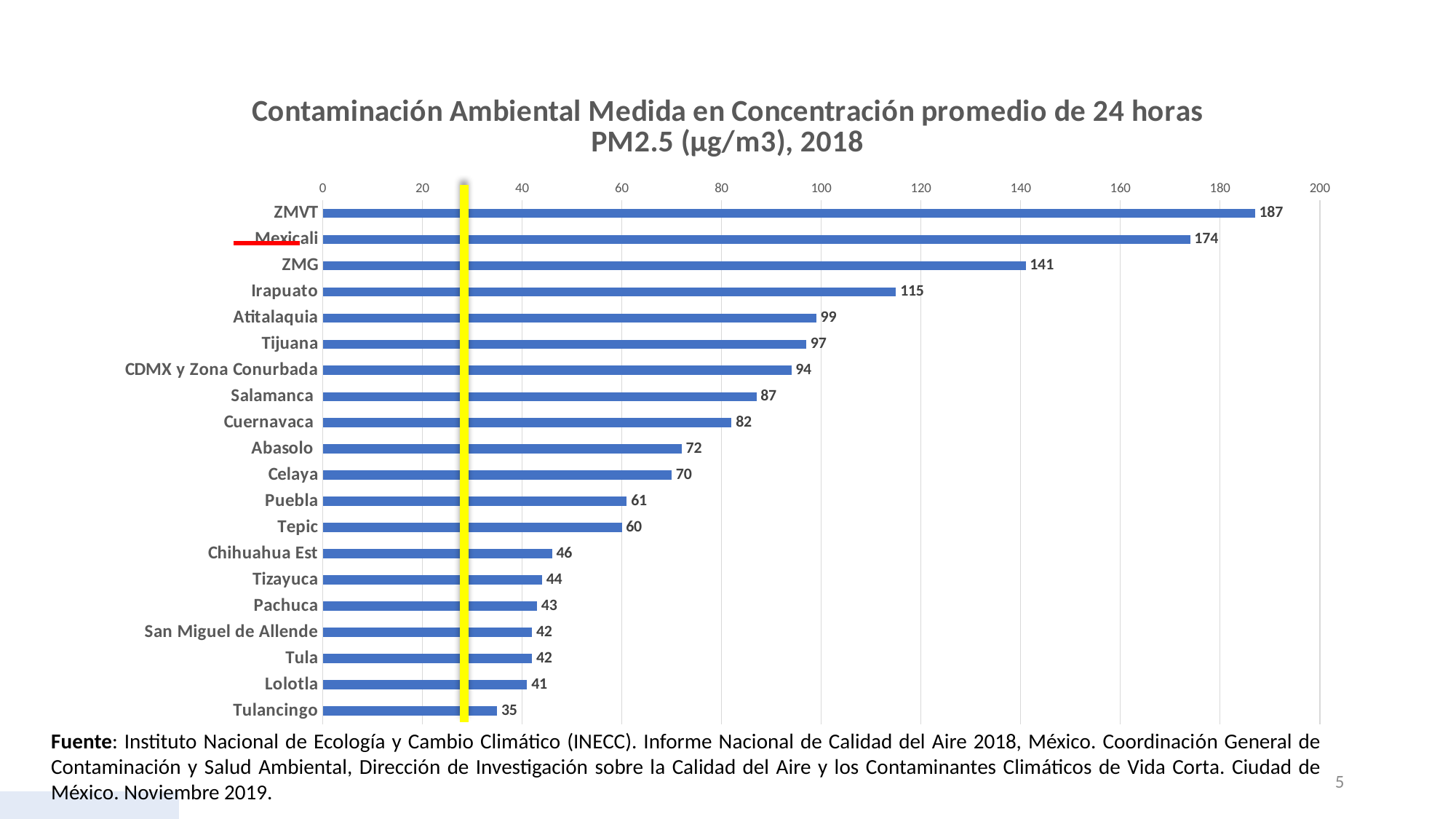
Which category has the lowest PM2.5 value? Tulancingo What is the difference between the values for ZMG and Irapuato? 26 What kind of chart is shown on the slide? bar chart What is the PM2.5 value for CDMX y Zona Conurbada? 94 Which category has the highest PM2.5 value? ZMVT What is the PM2.5 value for Mexicali? 174 How many categories are shown in the chart? 20 What is the difference between the values for ZMVT and Mexicali? 13 What year is stated in the chart title? 2018 Is the value for Cuernavaca greater or less than 100? less What is the PM2.5 value for Tepic? 60 Which has a larger value, Tijuana or Salamanca? Tijuana